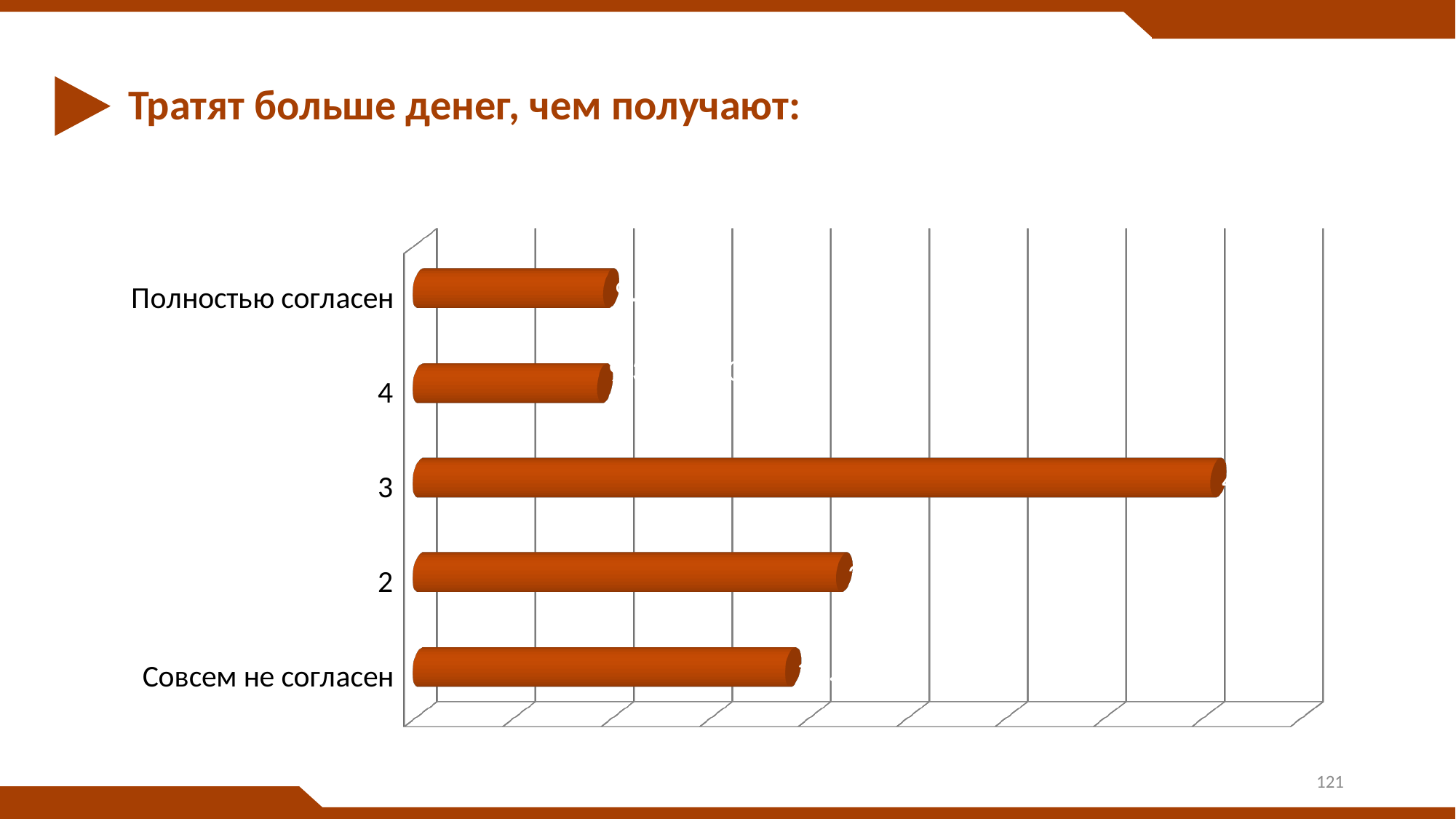
Which category has the longest bar in the chart? 3 How many categories are shown in the chart? 5 Which bar is longer, the one for "3" or the one for "Полностью согласен"? 3 Which bar is longer, the one for "Совсем не согласен" or the one for "Полностью согласен"? Совсем не согласен Which bar is longer, the one for "2" or the one for "Совсем не согласен"? 2 Are the bars in the chart drawn horizontally or vertically? Horizontally What kind of chart is shown on the slide? Bar chart What is the title of the slide above the chart? Тратят больше денег, чем получают: